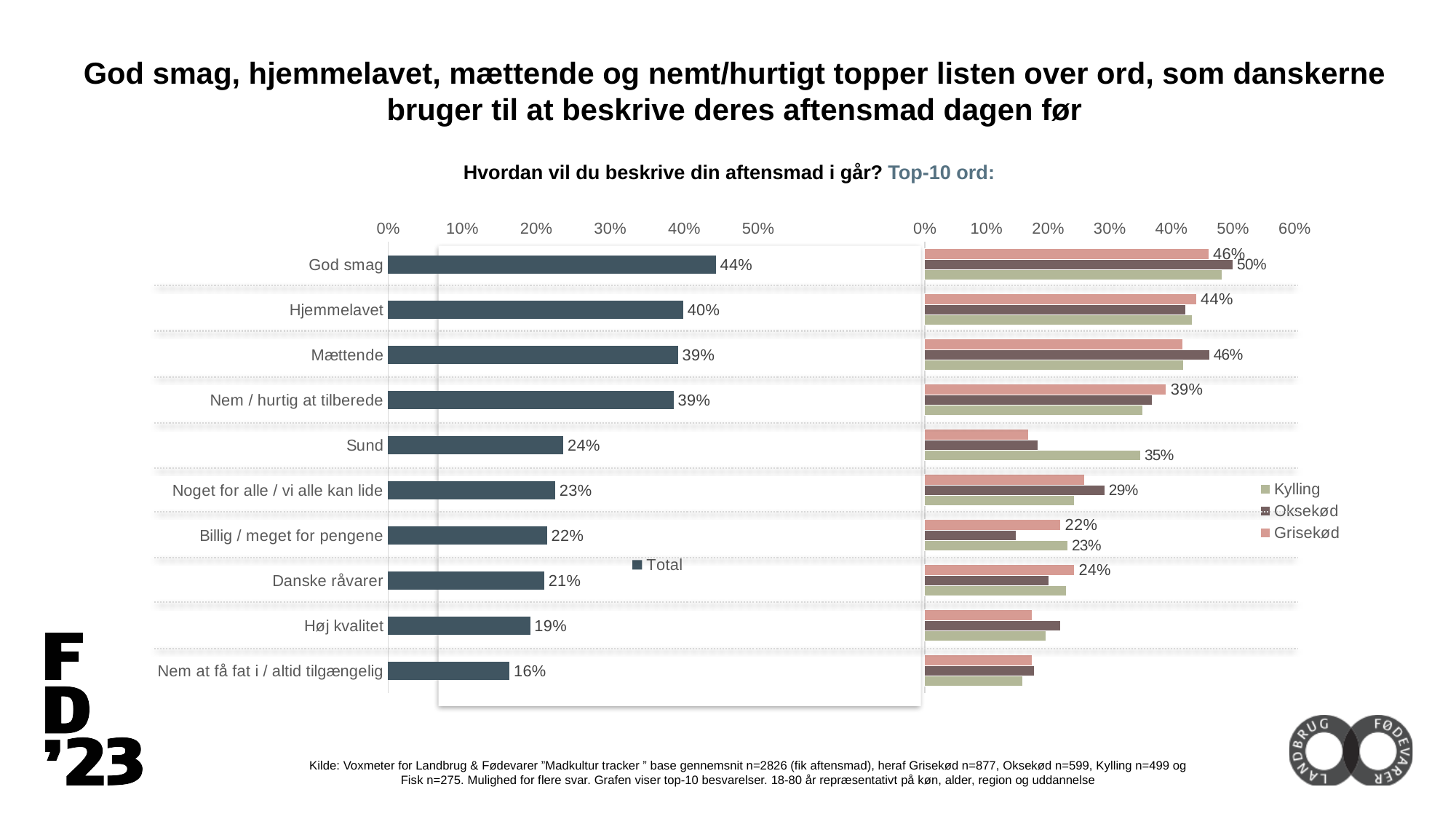
In the right chart, what is the value for Oksekød for Mættende? 46% In the left chart (Total), which category has the highest value? God smag In the left chart (Total), which is larger: Danske råvarer or Høj kvalitet? Danske råvarer What kind of chart is the left chart (Total)? Bar chart In the left chart (Total), what is the difference between God smag and Sund? 20% In the left chart (Total), which category has the lowest value? Nem at få fat i / altid tilgængelig How many series does the legend of the right chart list? 3 In the right chart, what is the value for Kylling for Sund? 35% In the right chart, is the value for Grisekød for Sund greater or less than 20%? less How many categories are shown in the left chart (Total)? 10 Which series does the legend of the left chart list? Total In the left chart (Total), what is the value for Hjemmelavet? 40%